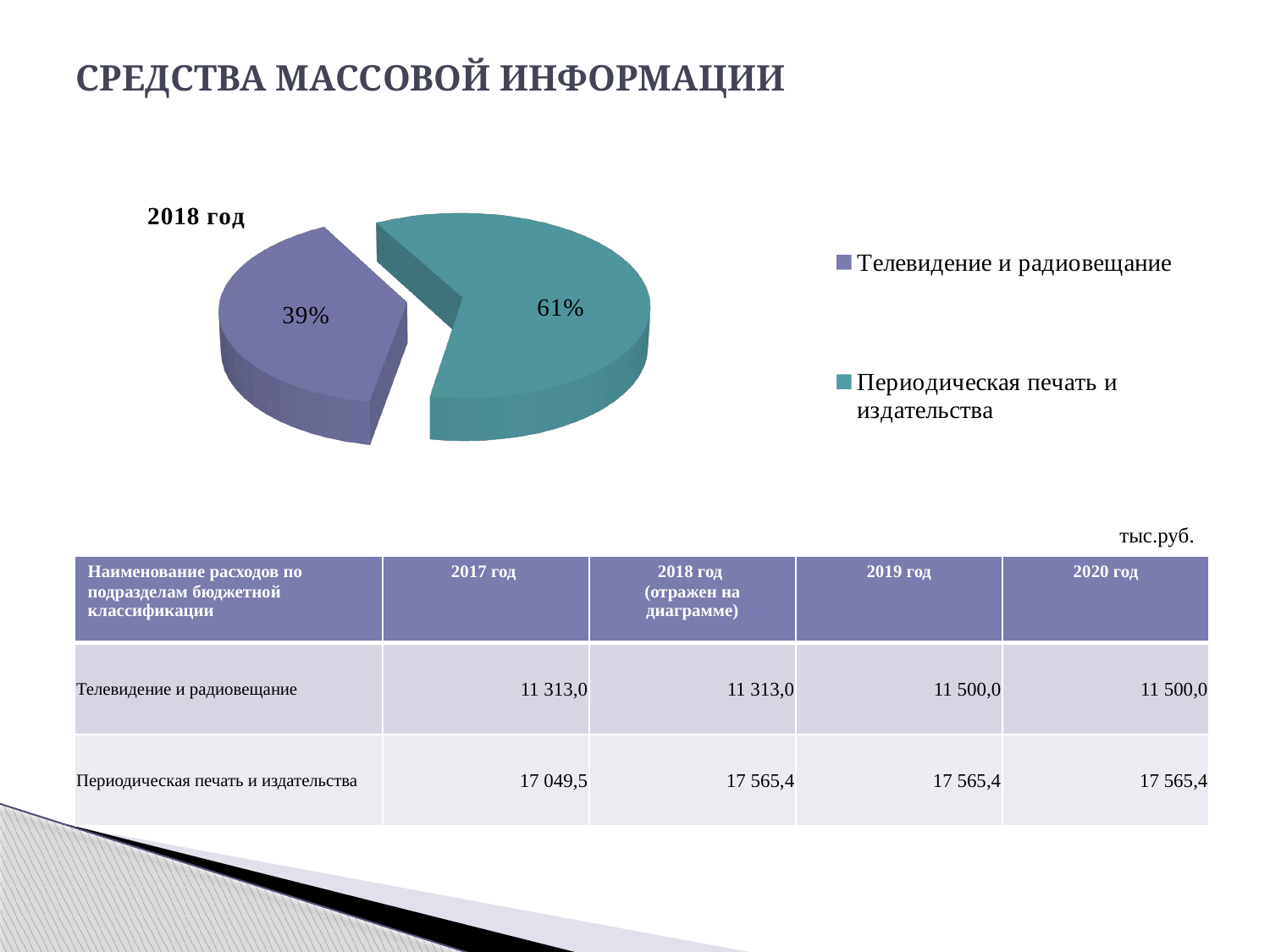
What is the difference in percentage points between the two slices of the pie chart? 22 Which slice of the pie chart is the largest? Периодическая печать и издательства What share of the pie does "Телевидение и радиовещание" have? 39% What is the title of the pie chart? 2018 год What kind of chart is shown on the slide? Pie chart What share of the pie does "Периодическая печать и издательства" have? 61% How many slices does the pie chart have? 2 Which slice of the pie chart is the smallest? Телевидение и радиовещание How many entries does the legend of the pie chart list? 2 Which is larger in the pie chart: "Телевидение и радиовещание" or "Периодическая печать и издательства"? Периодическая печать и издательства Which legend entry is shown in teal in the pie chart? Периодическая печать и издательства